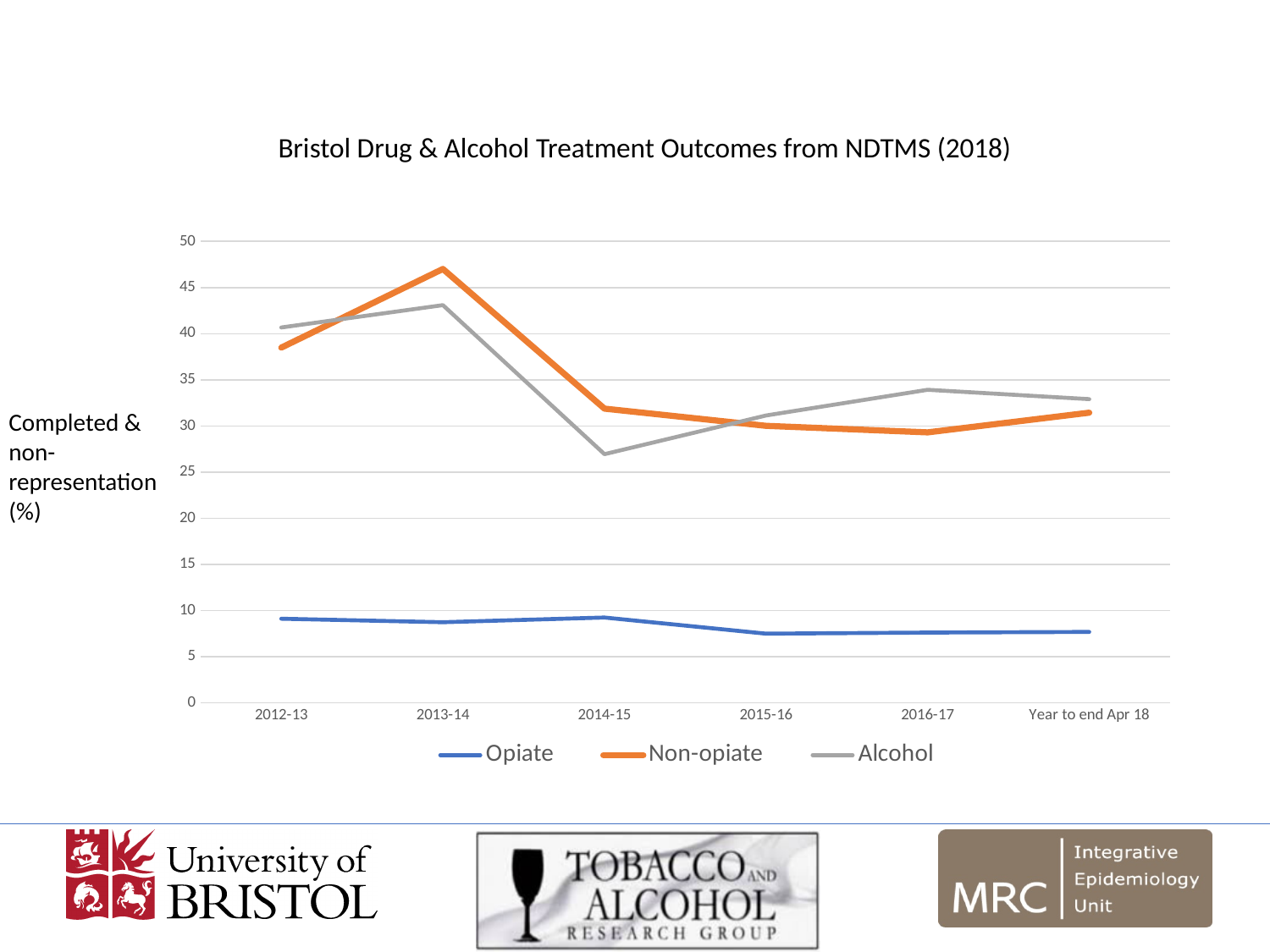
Is the value for Non-opiate in 2013-14 greater or less than 45? greater In which period does the Alcohol series reach its lowest value? 2014-15 How many series does the legend list? 3 How many time periods are shown along the x axis? 6 Which series is shown in orange in the legend? Non-opiate What is the title of the chart? Bristol Drug & Alcohol Treatment Outcomes from NDTMS (2018) Is the value for Opiate in 2015-16 greater or less than 10? less Is the value for Alcohol in 2014-15 greater or less than 30? less In which period does the Non-opiate series reach its highest value? 2013-14 Does the Non-opiate series rise or fall between 2013-14 and 2014-15? fall Which is larger in 2014-15, the Non-opiate value or the Alcohol value? Non-opiate What kind of chart is shown on the slide? line chart